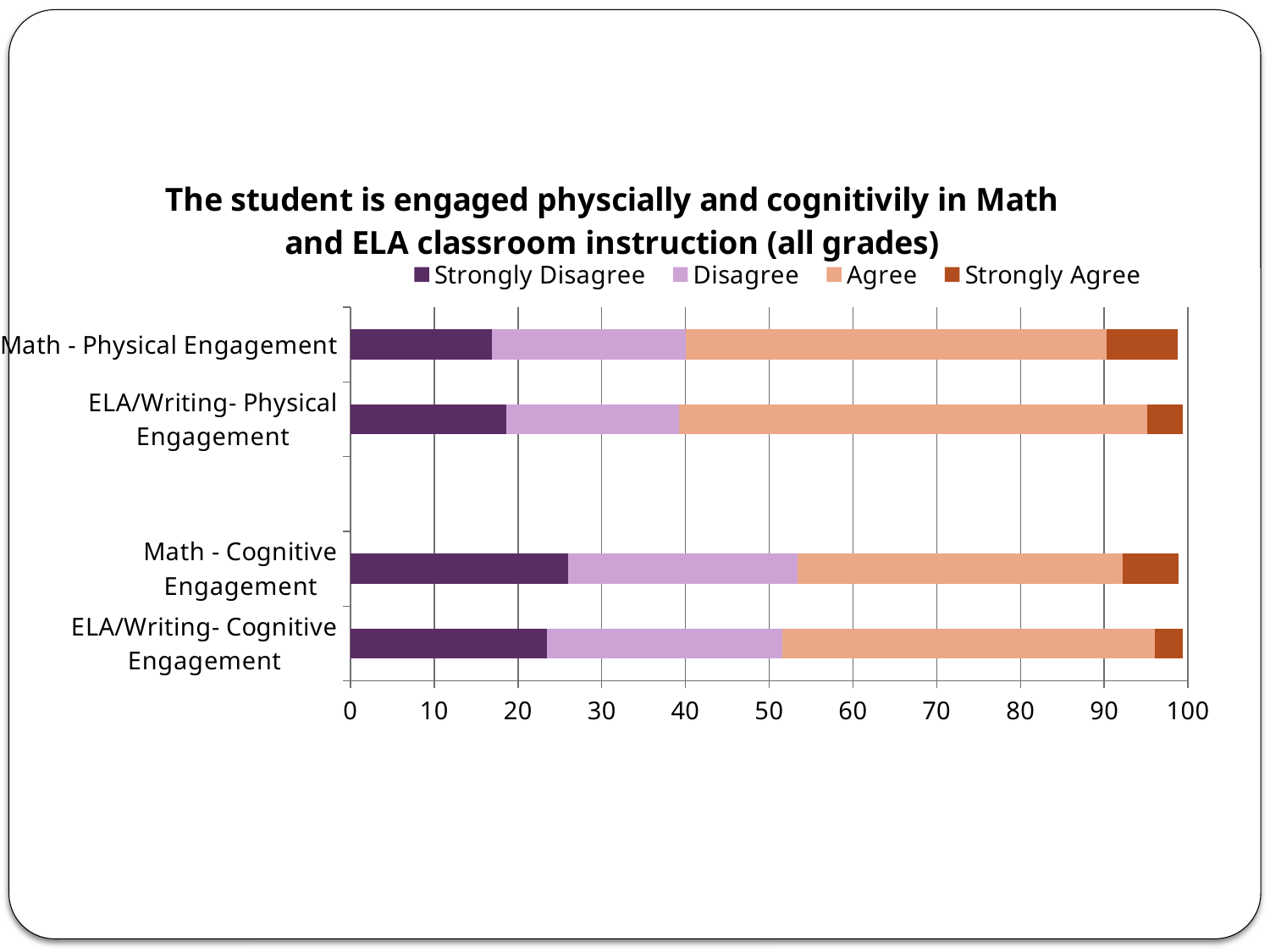
What is the title of the chart? The student is engaged physcially and cognitivily in Math and ELA classroom instruction (all grades) Which has the larger Strongly Disagree segment, Math - Physical Engagement or Math - Cognitive Engagement? Math - Cognitive Engagement Is the Agree value for Math - Cognitive Engagement greater or less than 50? less Is the Strongly Disagree value for Math - Cognitive Engagement greater or less than 20? greater How many categories are plotted on the chart? 4 What kind of chart is shown on the slide? Bar chart How many series does the legend list? 4 Is the Agree value for ELA/Writing- Physical Engagement greater or less than 50? greater Which series is listed first in the legend? Strongly Disagree Which category has the largest Agree segment? ELA/Writing- Physical Engagement